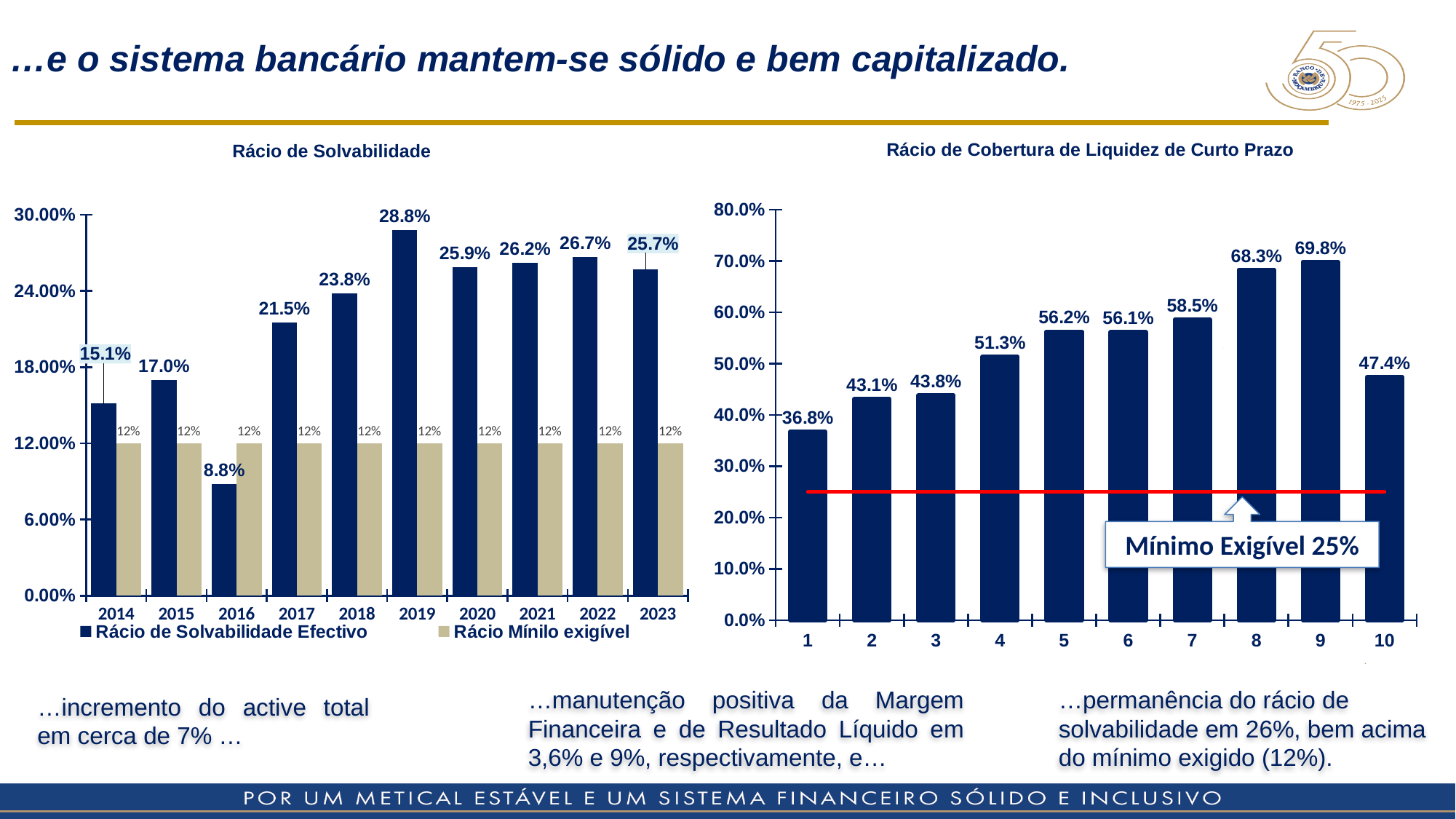
In the 'Rácio de Solvabilidade' chart, which year has the lowest Rácio de Solvabilidade Efectivo? 2016 In the 'Rácio de Cobertura de Liquidez de Curto Prazo' chart, what is the value for category 9? 69.8% In the 'Rácio de Cobertura de Liquidez de Curto Prazo' chart, what minimum required level does the red line mark? 25% In the 'Rácio de Solvabilidade' chart, how many years are shown on the x axis? 10 In the 'Rácio de Solvabilidade' chart, what is the difference between the Rácio de Solvabilidade Efectivo in 2023 and the Rácio Mínilo exigível in 2023? 13.7% In the 'Rácio de Solvabilidade' chart, what is the value of Rácio de Solvabilidade Efectivo for 2019? 28.8% In the 'Rácio de Solvabilidade' chart, which year has the highest Rácio de Solvabilidade Efectivo? 2019 What type of chart is the 'Rácio de Cobertura de Liquidez de Curto Prazo' chart? Bar chart In the 'Rácio de Solvabilidade' chart, is the Rácio de Solvabilidade Efectivo larger in 2022 or in 2023? 2022 In the 'Rácio de Cobertura de Liquidez de Curto Prazo' chart, what is the difference between the values for category 9 and category 10? 22.4% In the 'Rácio de Solvabilidade' chart, how many series does the legend list? 2 In the 'Rácio de Cobertura de Liquidez de Curto Prazo' chart, which category has the lowest value? 1